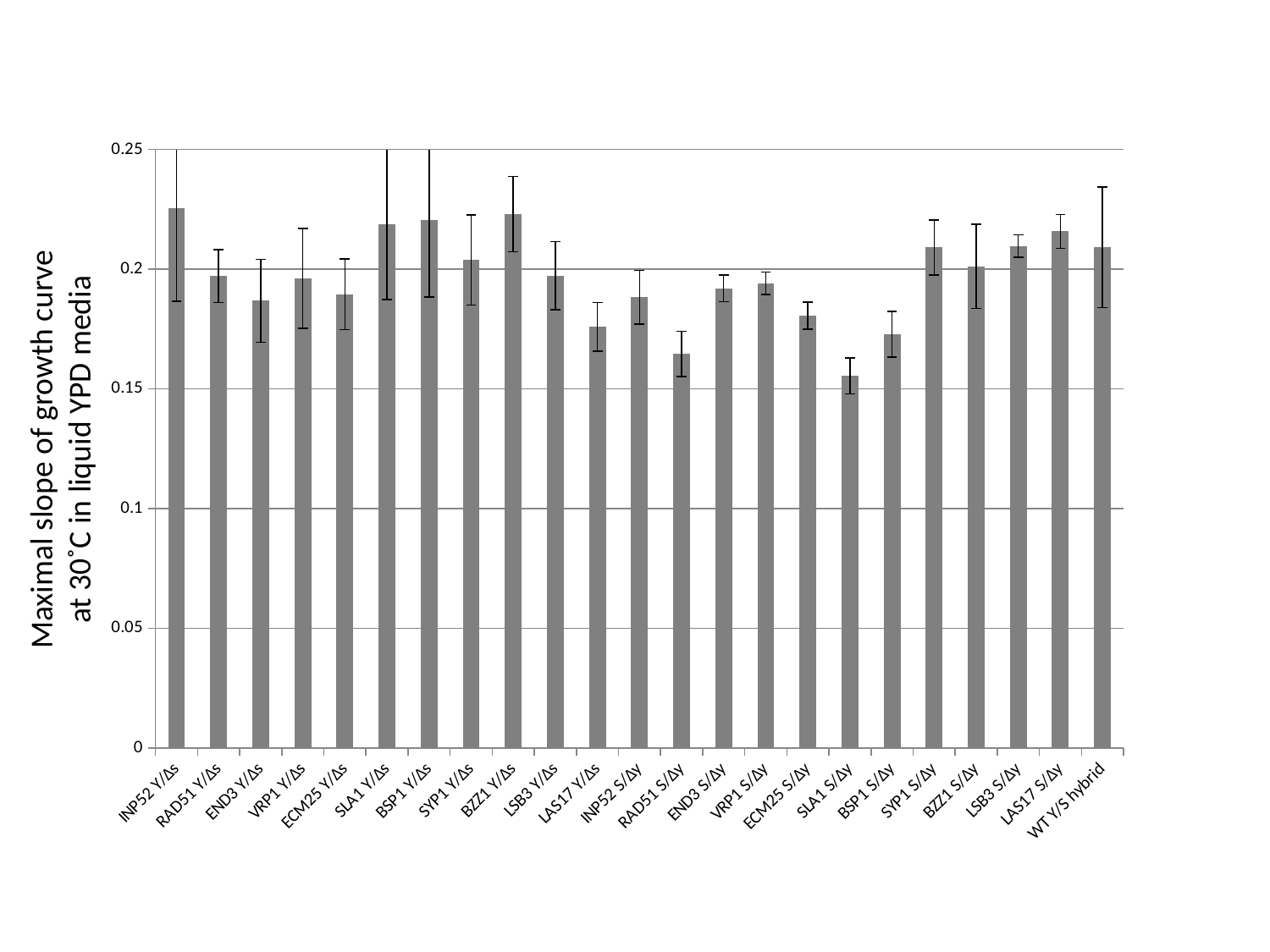
Is the value for INP52 Y/Δs greater or less than 0.2? greater What is the title of the vertical axis? Maximal slope of growth curve at 30°C in liquid YPD media Which has the larger value, LAS17 S/Δy or BSP1 S/Δy? LAS17 S/Δy Is the value for LAS17 S/Δy greater or less than 0.2? greater How many categories (bars) are plotted on the chart? 23 Which has the larger value, INP52 Y/Δs or SLA1 S/Δy? INP52 Y/Δs What is the maximum value shown on the vertical axis? 0.25 Which category has the lowest maximal slope of growth curve? SLA1 S/Δy Is the value for ECM25 S/Δy greater or less than 0.2? less What kind of chart is shown on the slide? bar chart